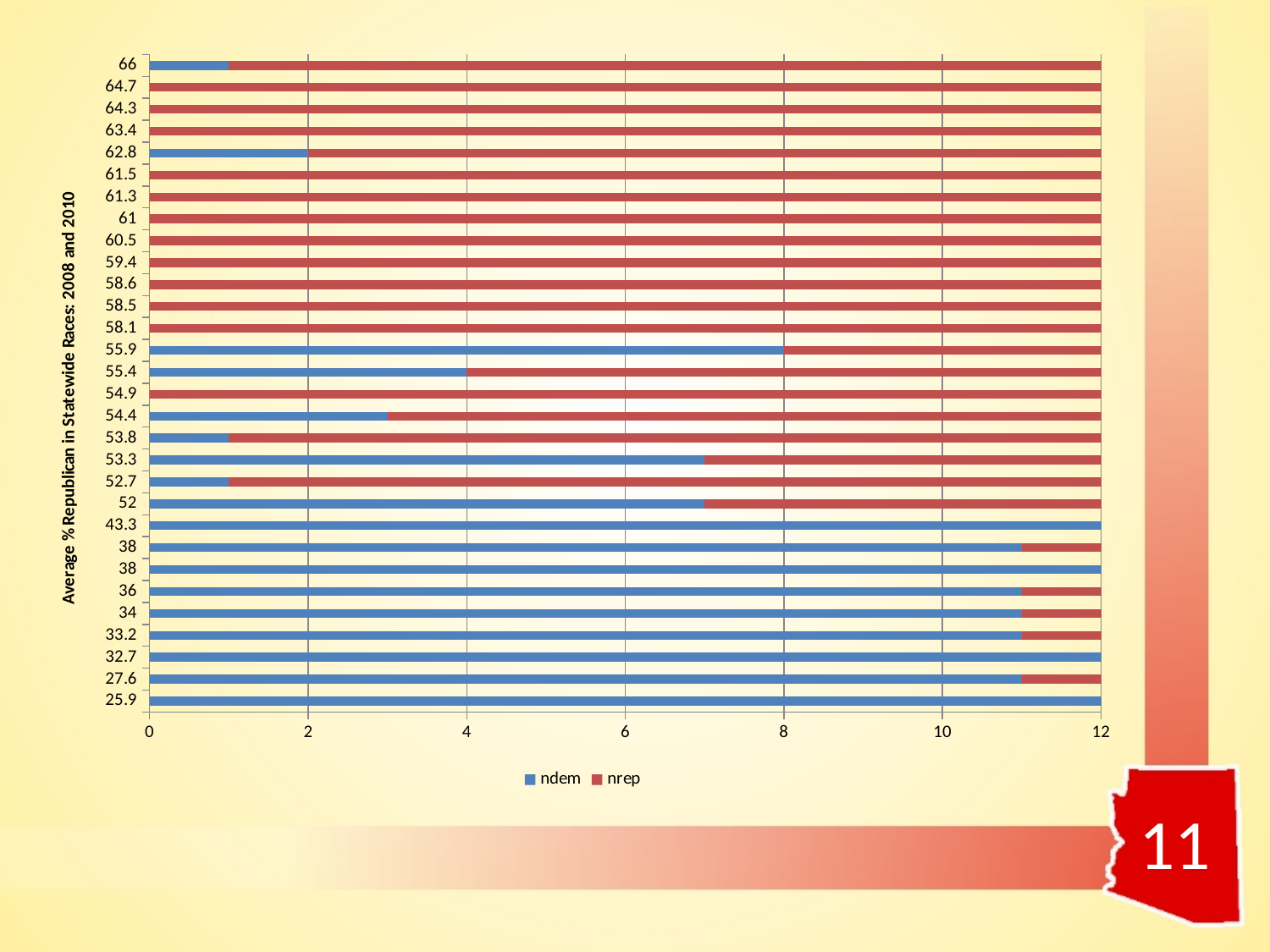
What is the ndem value for the category labelled 62.8? 2 What kind of chart is shown on the slide? Stacked bar chart How many categories are plotted on the vertical axis? 30 What are the two series named in the legend? ndem and nrep What is the ndem value for the category labelled 43.3? 12 Is the ndem value for the category labelled 53.3 greater or less than 6? greater What is the difference between the ndem value for the category labelled 55.9 and the ndem value for the category labelled 55.4? 4 What is the ndem value for the category labelled 55.9? 8 Which has the larger ndem value, the category labelled 55.9 or the category labelled 55.4? 55.9 Is the nrep value for the category labelled 64.7 greater or less than 10? greater What is the ndem value for the category labelled 55.4? 4 How many series does the legend list? 2